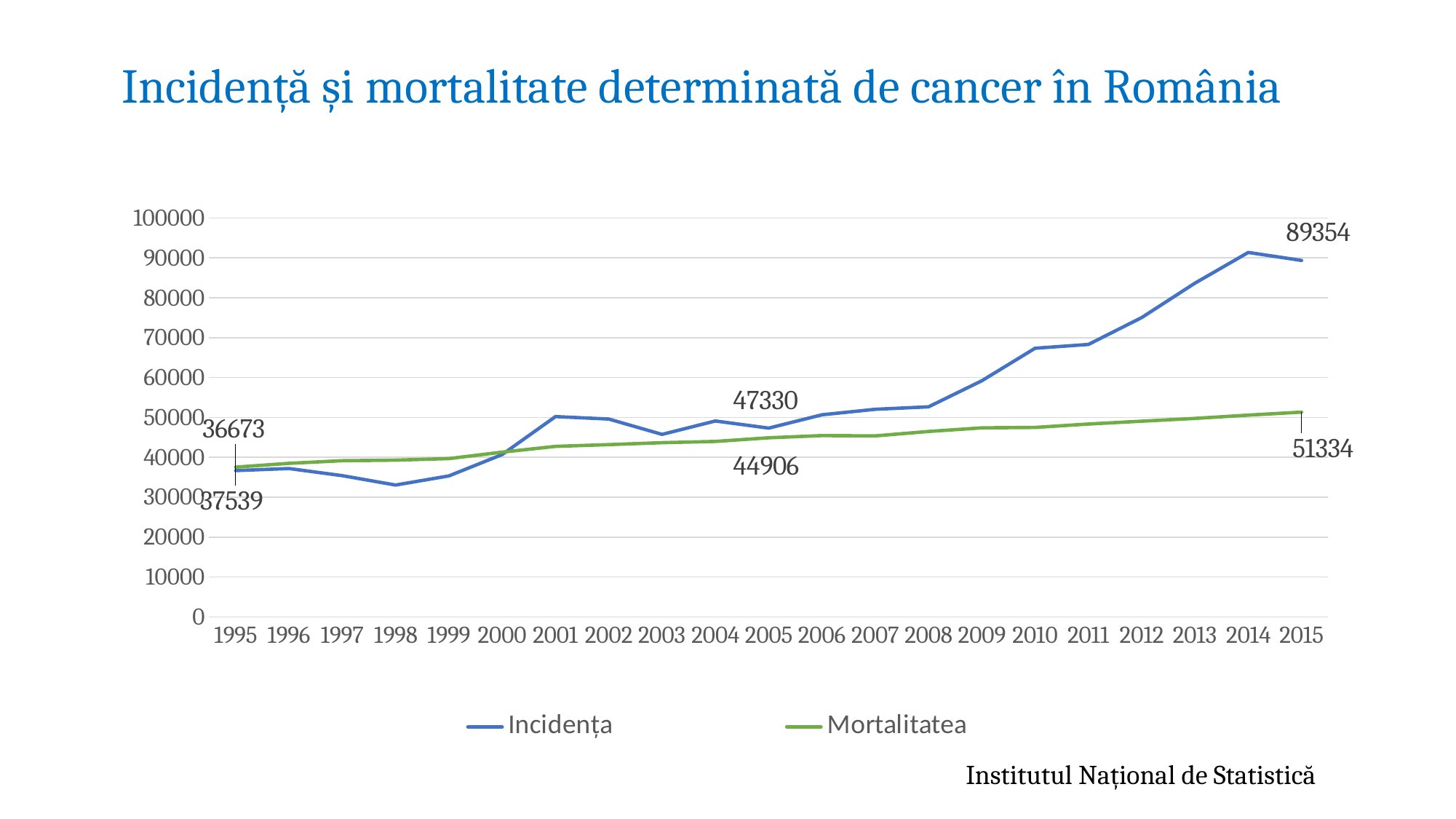
What is the difference between Incidența and Mortalitatea in 2015? 38020 Is the value of Incidența in 2010 greater or less than 60000? greater What is the value of Incidența in 2005? 47330 In 1995, which series has the higher value, Incidența or Mortalitatea? Mortalitatea In which year does Incidența reach its highest value? 2014 What is the value of Mortalitatea in 1995? 37539 What is the value of Mortalitatea in 2015? 51334 How many years are shown on the x axis? 21 What is the difference between Incidența and Mortalitatea in 2005? 2424 In which year is Incidența at its lowest? 1998 What type of chart is shown on the slide? line chart What is the value of Incidența in 2015? 89354